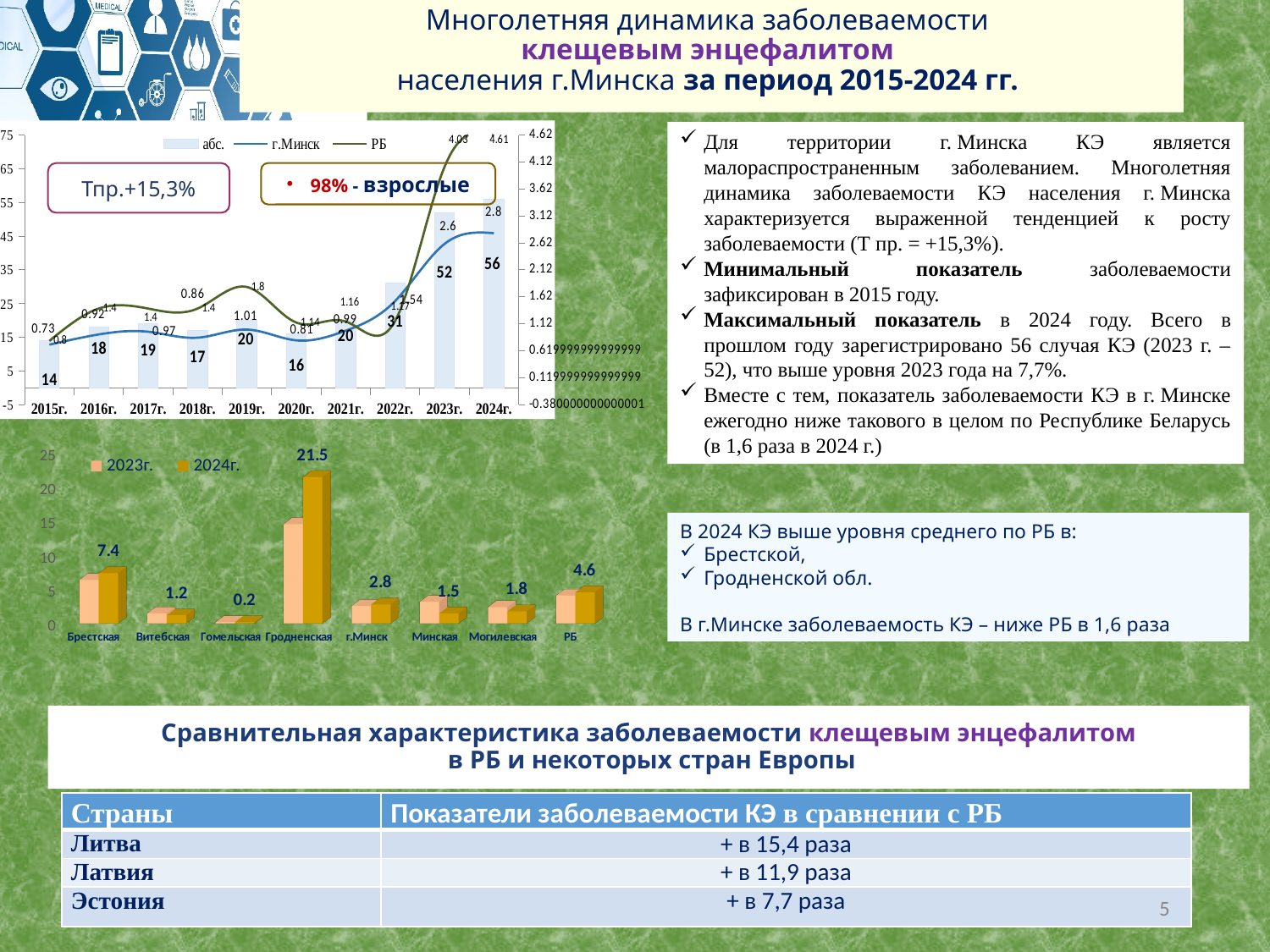
How many series does the legend of the bottom-left chart list? 2 What kind of chart is the bottom-left chart? bar chart In the top chart, which year has the highest абс. bar? 2024г. How many series does the legend of the top chart list? 3 In the top chart, what is the difference between the абс. bars for 2024г. and 2023г.? 4 In the bottom-left chart, what is the labelled value for Гомельская? 0.2 In the top chart, what is the value of the абс. bar for 2015г.? 14 In the top chart, what is the value of the абс. bar for 2024г.? 56 How many years are shown on the x axis of the top chart? 10 In the top chart, do the абс. bars rise or fall from 2022г. to 2024г.? rise In the top chart, which year has the lowest абс. bar? 2015г. In the bottom-left chart, which region has the highest labelled value? Гродненская